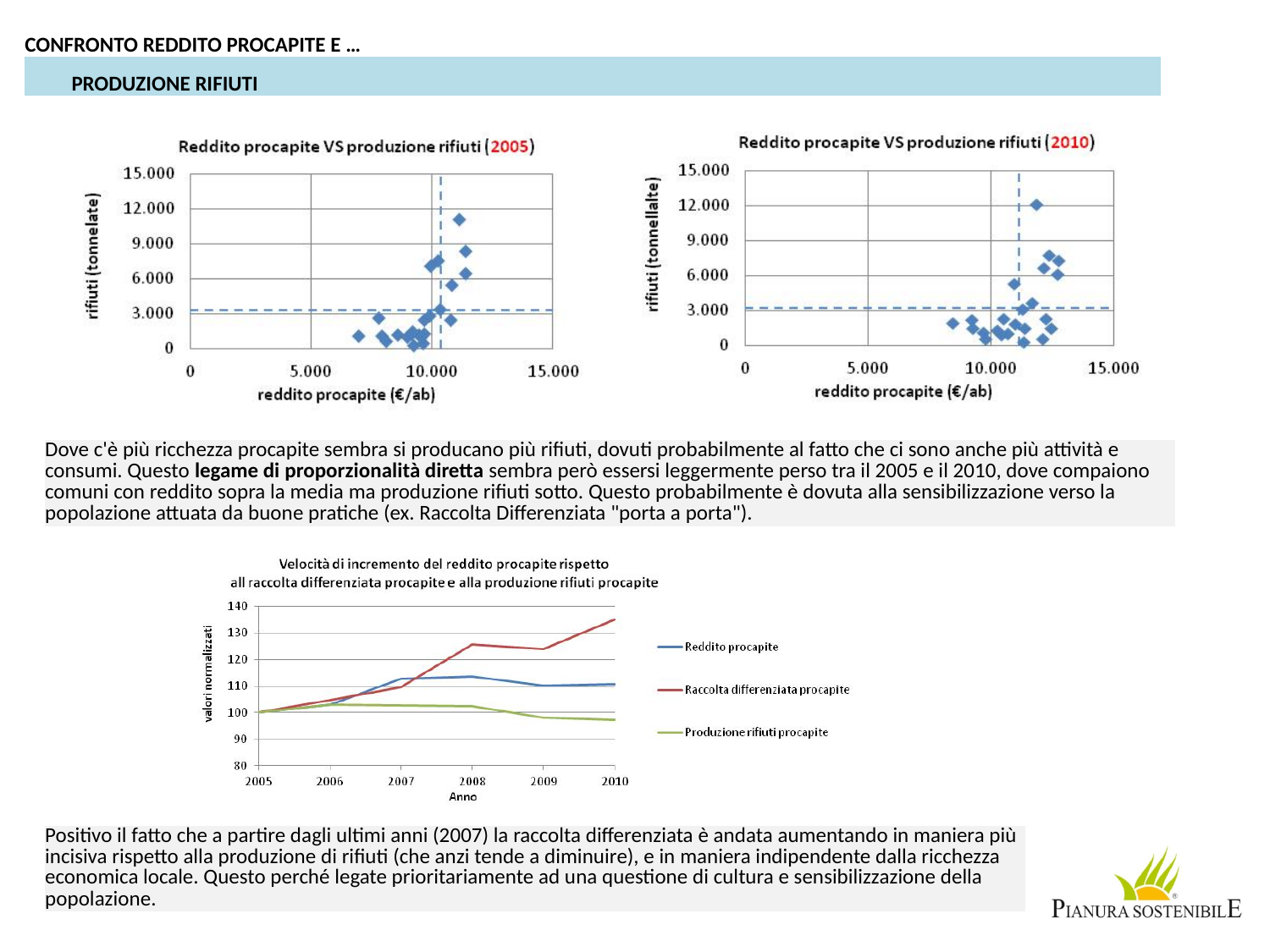
In the bottom line chart, which series has the highest value in 2010? Raccolta differenziata procapite In the 'Reddito procapite VS produzione rifiuti (2010)' chart, what is the label of the x axis? reddito procapite (€/ab) In the bottom line chart, which is larger in 2008: 'Reddito procapite' or 'Raccolta differenziata procapite'? Raccolta differenziata procapite What kind of chart is the 'Reddito procapite VS produzione rifiuti (2005)' chart? scatter chart In the bottom line chart, which series has the lowest value in 2010? Produzione rifiuti procapite In the bottom line chart, is the value for 'Raccolta differenziata procapite' in 2010 greater or less than 130? greater In the bottom line chart, does the 'Produzione rifiuti procapite' series rise or fall from 2008 to 2010? fall In the bottom line chart, how many years are shown on the x axis? 6 In the bottom line chart, does the 'Raccolta differenziata procapite' series rise or fall from 2005 to 2010? rise In the bottom line chart, how many series does the legend list? 3 In the bottom line chart, is the value for 'Produzione rifiuti procapite' in 2010 greater or less than 100? less What kind of chart is the bottom chart, 'Velocità di incremento del reddito procapite...'? line chart